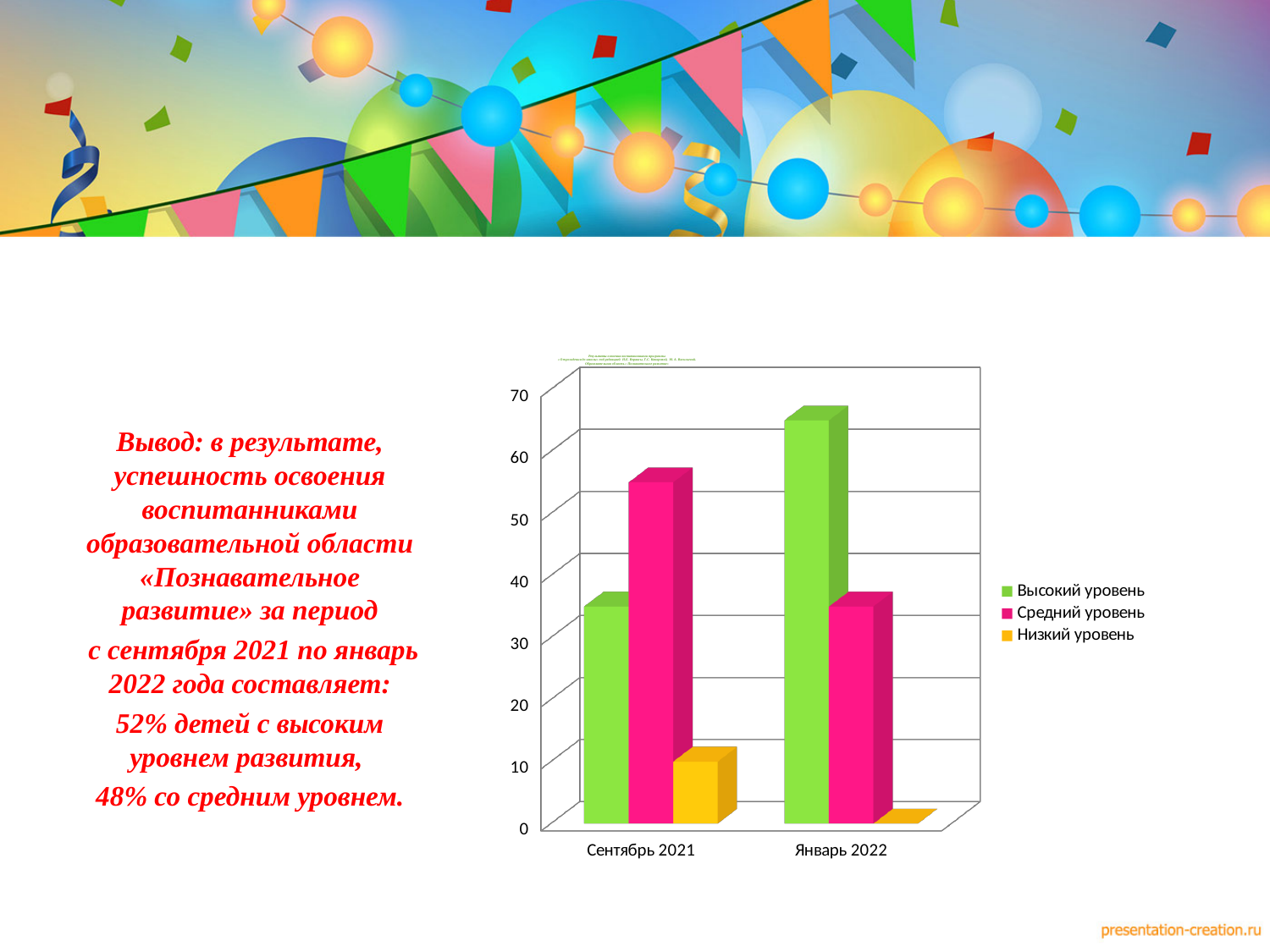
Which series has the highest value for Январь 2022? Высокий уровень How many categories are shown on the x axis of the chart? 2 Is the value for Средний уровень in Сентябрь 2021 greater or less than 50? greater Does the value for Средний уровень rise or fall from Сентябрь 2021 to Январь 2022? fall Which series has the highest value for Сентябрь 2021? Средний уровень Is the value for Низкий уровень in Сентябрь 2021 greater or less than 20? less Which series has the lowest value for Январь 2022? Низкий уровень What kind of chart is shown on the slide? bar chart How many series does the chart legend list? 3 Which is larger: Высокий уровень in Сентябрь 2021 or Высокий уровень in Январь 2022? Январь 2022 Is the value for Высокий уровень in Январь 2022 greater or less than 60? greater What colour represents Высокий уровень in the chart legend? green